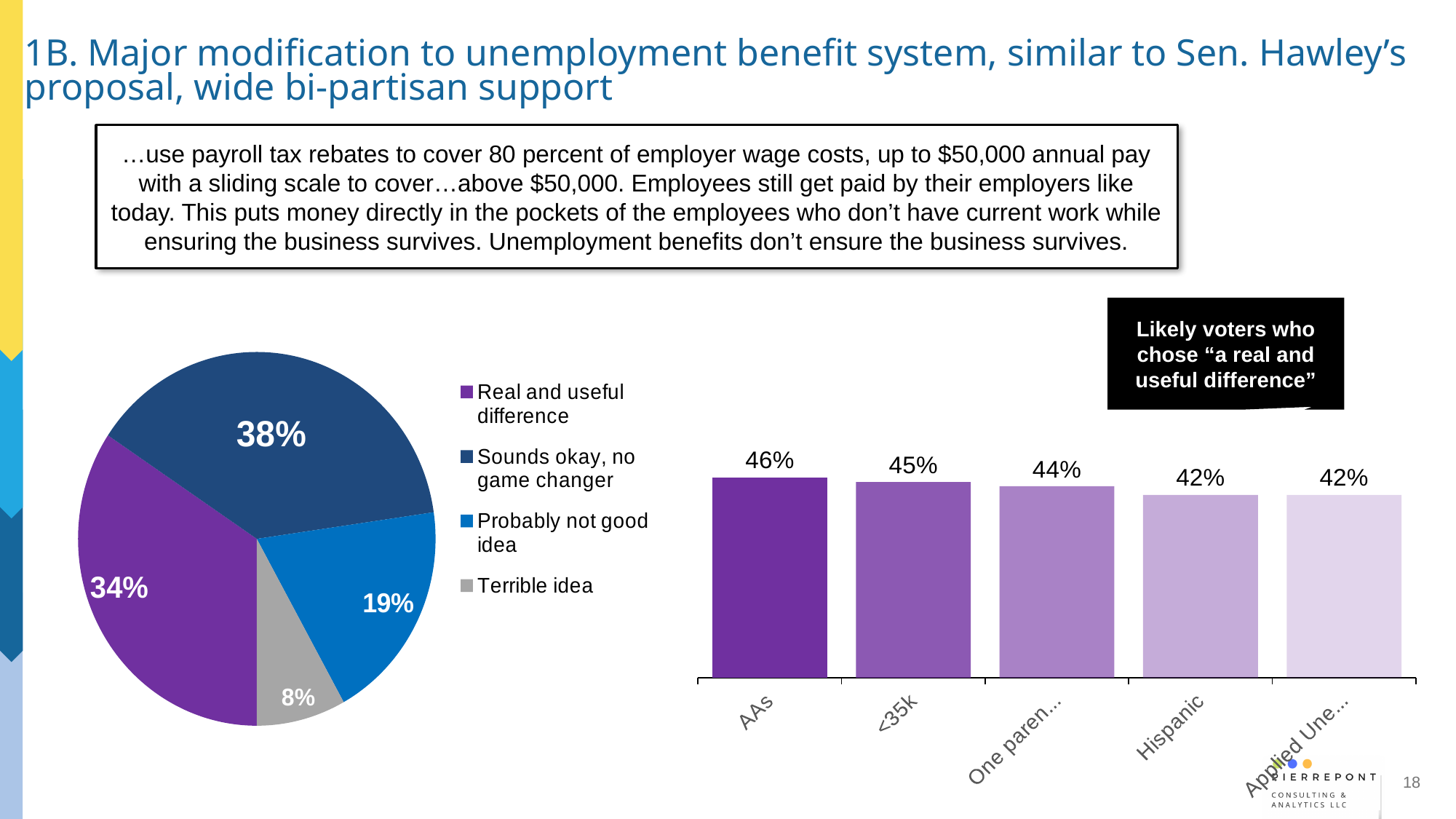
In the pie chart on the left, which response has the smallest slice? Terrible idea In the bar chart on the right, what is the difference between the values for AAs and <35k? 1% In the pie chart on the left, which response has the largest slice? Sounds okay, no game changer In the pie chart on the left, how many response categories does the legend list? 4 In the pie chart on the left, what share of respondents chose "Sounds okay, no game changer"? 38% In the pie chart on the left, what share of respondents chose "Real and useful difference"? 34% In the bar chart on the right, what is the value for AAs? 46% In the bar chart on the right, which group has the highest value? AAs In the pie chart on the left, what is the difference between the "Probably not good idea" slice and the "Terrible idea" slice? 11% What type of chart is shown on the right side of the slide? Bar chart In the bar chart on the right, what is the value for Hispanic? 42% In the bar chart on the right, how many bars are plotted? 5